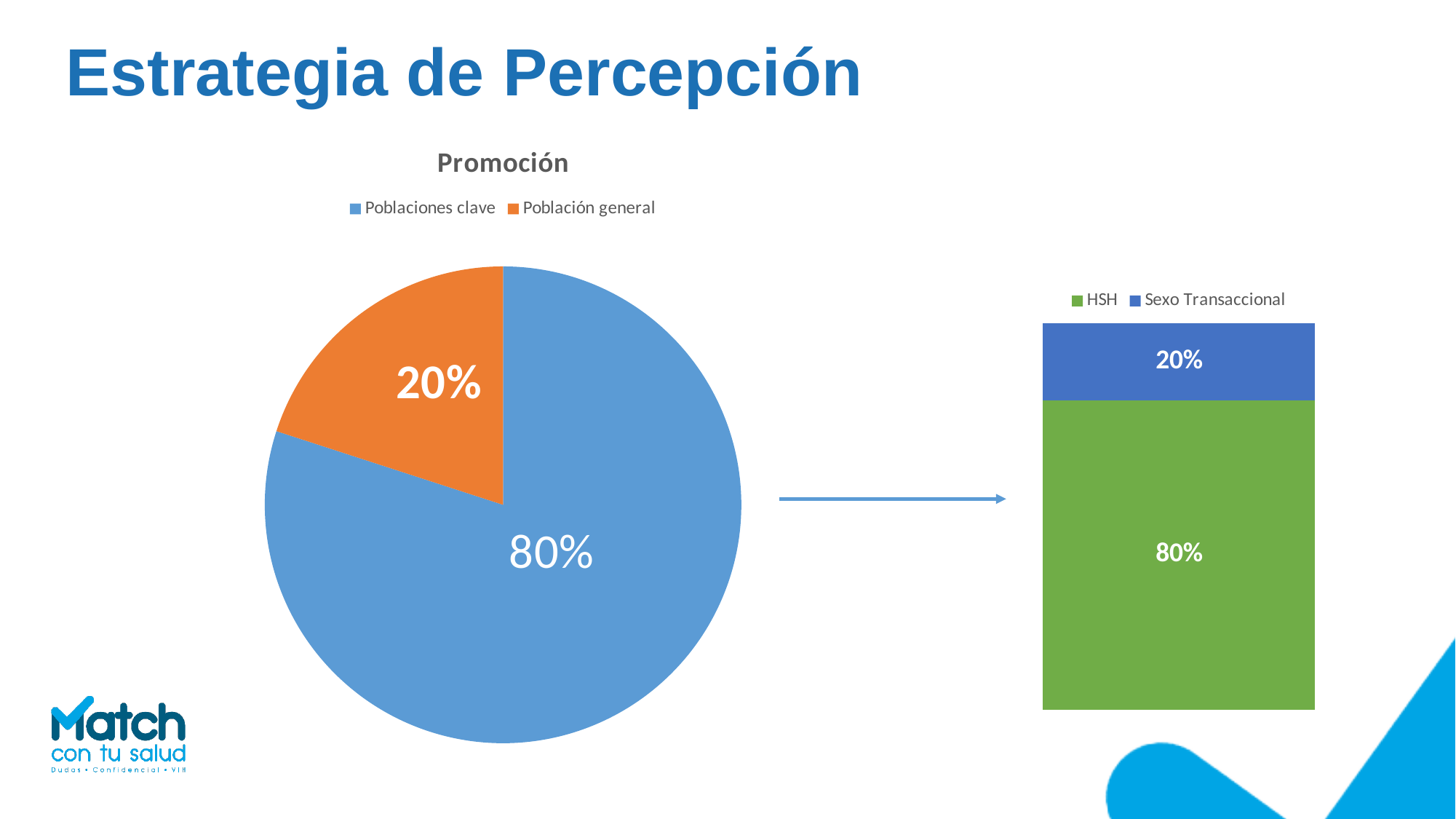
In the 'Promoción' pie chart, what is the difference between the 'Poblaciones clave' and 'Población general' shares? 60% In the stacked bar chart on the right, which is larger, 'HSH' or 'Sexo Transaccional'? HSH In the 'Promoción' pie chart, what share does 'Poblaciones clave' have? 80% In the stacked bar chart on the right, what is the value for 'HSH'? 80% In the stacked bar chart on the right, what is the total of the stacked bar? 100% In the stacked bar chart on the right, what is the value for 'Sexo Transaccional'? 20% In the 'Promoción' pie chart, which category has the largest slice? Poblaciones clave In the 'Promoción' pie chart, what share does 'Población general' have? 20% What kind of chart is the chart titled 'Promoción' on the left? Pie chart How many categories does the 'Promoción' pie chart show? 2 How many series does the legend of the chart on the right list? 2 In the 'Promoción' pie chart, which category has the smallest slice? Población general